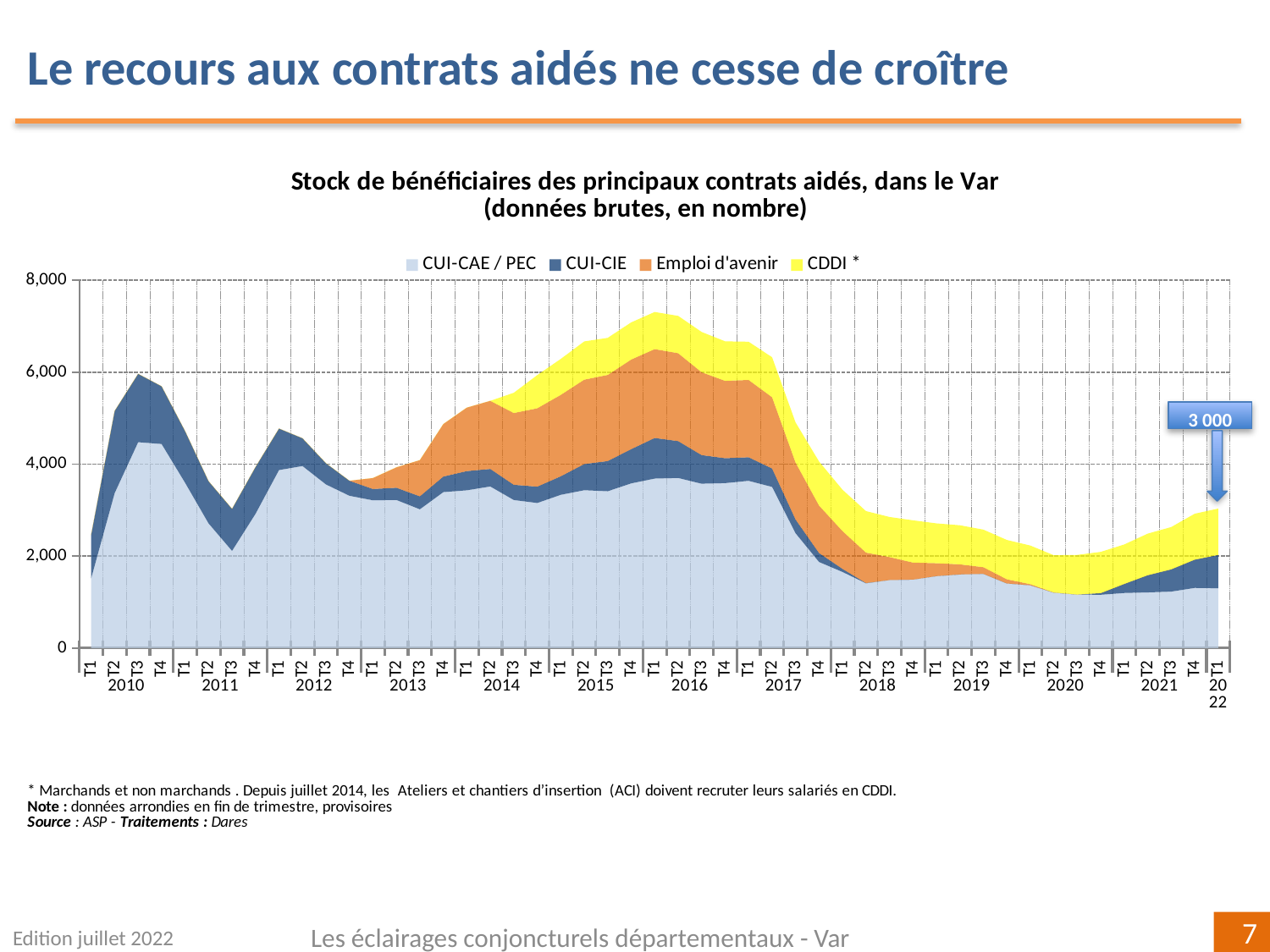
What kind of chart is shown on the slide? stacked area chart Which series is shown in yellow? CDDI * What total value does the annotation arrow indicate for T1 2022? 3 000 How many series does the legend list? 4 Is the total stock of beneficiaries at T3 2010 greater or less than 4,000? greater Does the total stock of beneficiaries rise or fall between T1 2020 and T1 2022? rise How many years are labelled on the x axis? 13 Is the total stock of beneficiaries at T3 2011 greater or less than 4,000? less Does the total stock of beneficiaries rise or fall between T1 2016 and T1 2018? fall Is the total stock of beneficiaries at T1 2016 greater or less than 6,000? greater